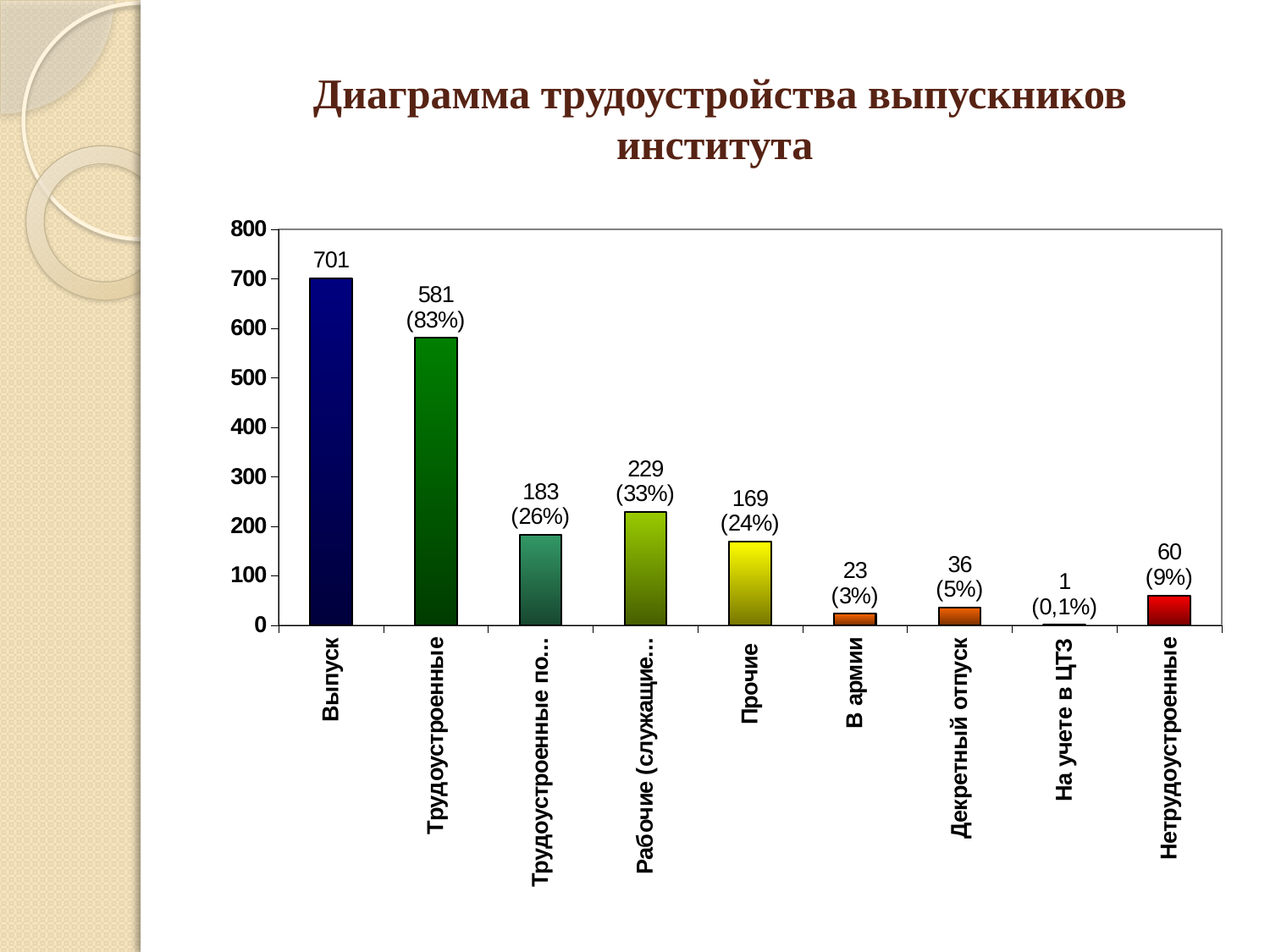
Which is larger, the value for Декретный отпуск or the value for В армии? Декретный отпуск What is the value for Нетрудоустроенные? 60 What is the value for Трудоустроенные? 581 What is the value for В армии? 23 What kind of chart is shown on the slide? bar chart How many categories are shown on the chart? 9 What is the value for Выпуск? 701 Which category has the highest value? Выпуск What is the difference between the values for Выпуск and Трудоустроенные? 120 Which category has the lowest value? На учете в ЦТЗ What percentage is shown in the data label for Трудоустроенные? 83% What is the value for Декретный отпуск? 36